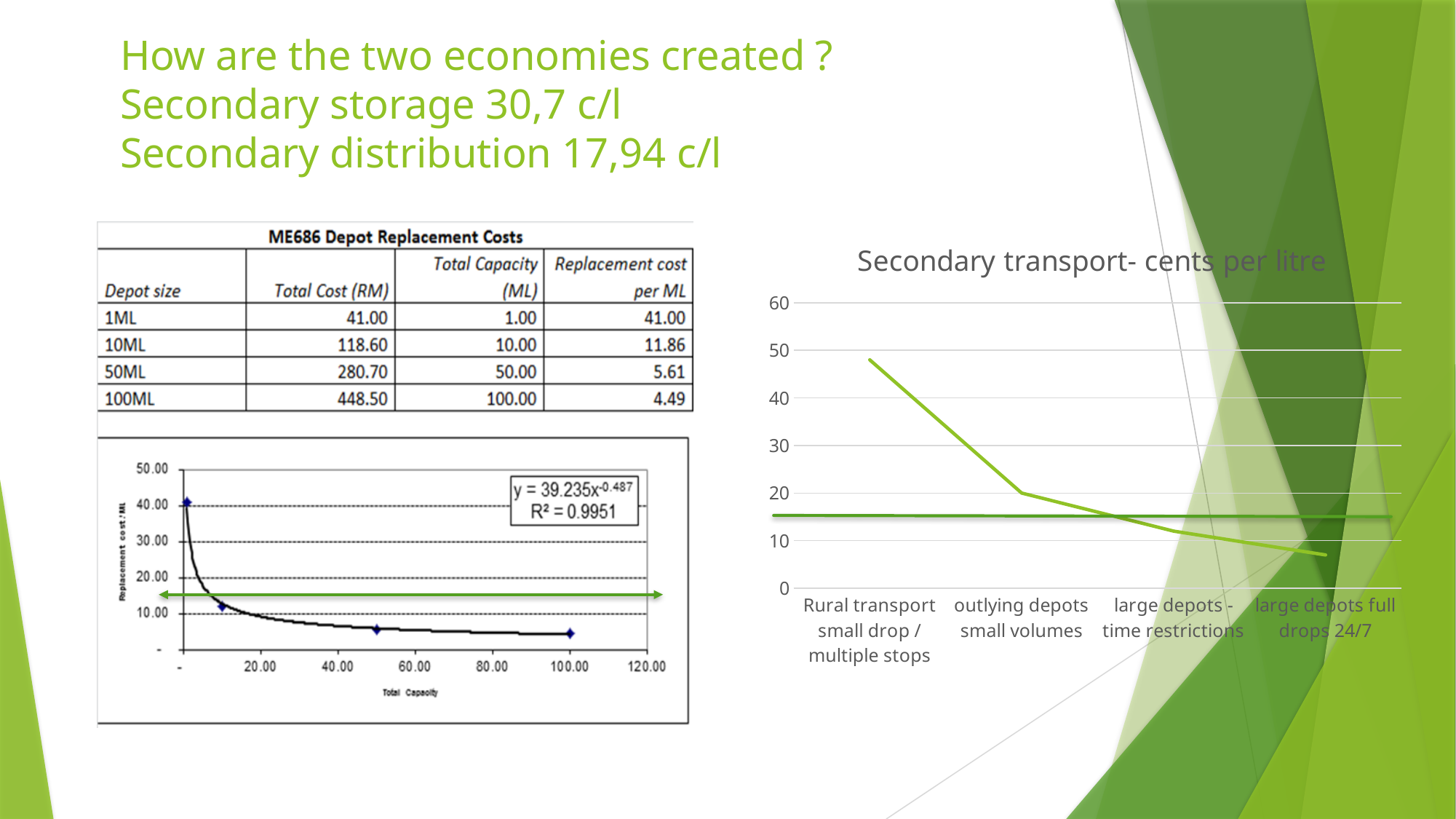
In the 'Secondary transport- cents per litre' chart, which is larger: the value for 'outlying depots small volumes' or the value for 'large depots - time restrictions'? outlying depots small volumes In the bottom-left chart of replacement cost against total capacity, what R² value is shown in the text box? R² = 0.9951 In the 'Secondary transport- cents per litre' chart, is the value for 'large depots full drops 24/7' greater or less than 10? less How many categories are shown on the x axis of the 'Secondary transport- cents per litre' chart? 4 What type of chart is the 'Secondary transport- cents per litre' chart on the right? line chart In the 'Secondary transport- cents per litre' chart, which category has the highest value? Rural transport small drop / multiple stops In the bottom-left chart of replacement cost against total capacity, does the replacement cost rise or fall as total capacity increases? fall In the 'Secondary transport- cents per litre' chart, do the values rise or fall from left to right along the x axis? fall In the 'Secondary transport- cents per litre' chart, which category has the lowest value? large depots full drops 24/7 In the 'Secondary transport- cents per litre' chart, is the value for 'Rural transport small drop / multiple stops' greater or less than 40? greater In the 'Secondary transport- cents per litre' chart, is the value for 'outlying depots small volumes' greater or less than 30? less What is the title of the chart on the right side of the slide? Secondary transport- cents per litre